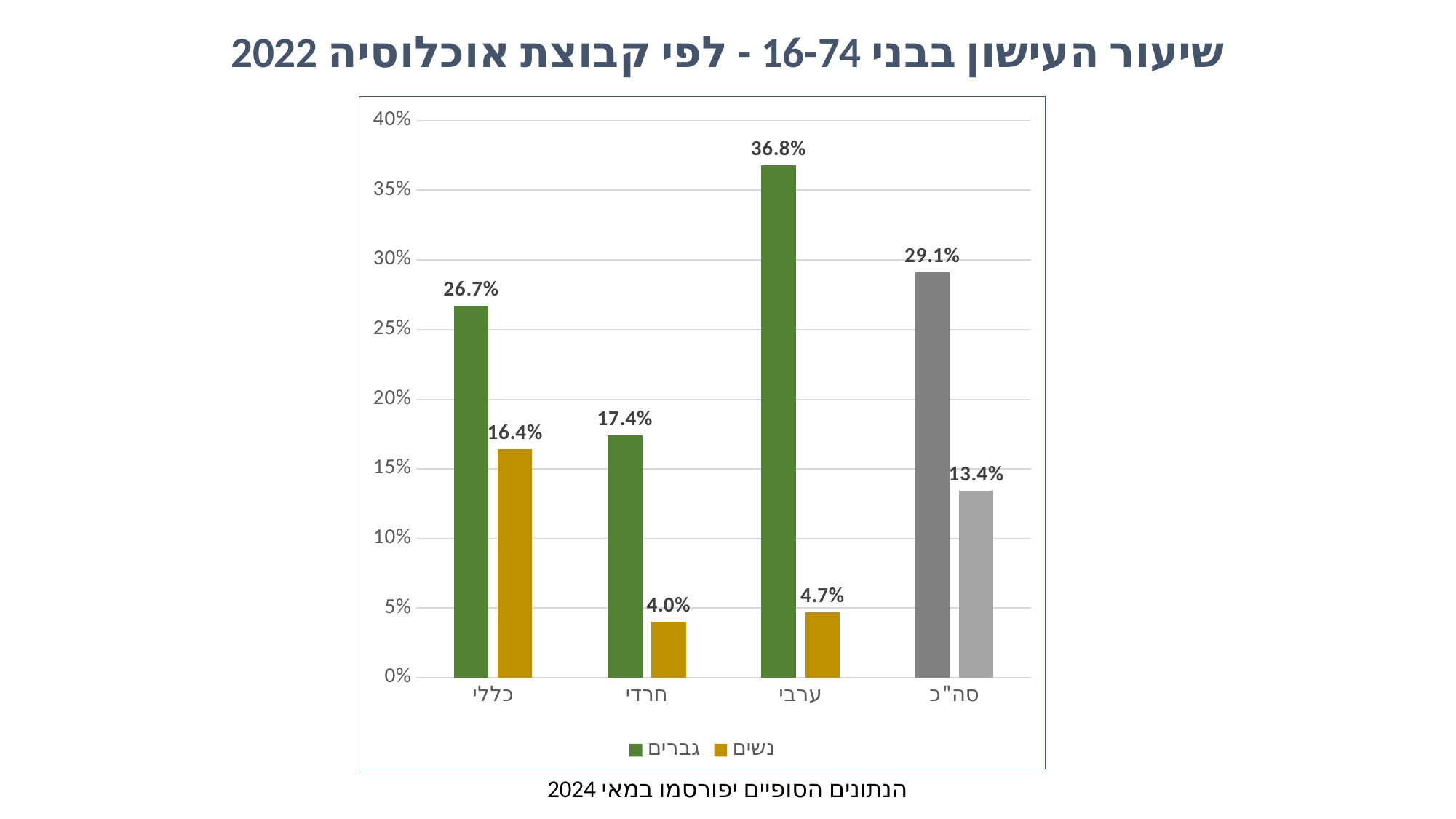
Which category has the highest value for גברים? ערבי What is the value for נשים in the סה"כ category? 13.4% How many series does the legend list? 2 Which is larger: the נשים value for כללי or the נשים value for סה"כ? כללי What is the value for גברים in the כללי category? 26.7% Is the value for גברים in the סה"כ category greater or less than 25%? greater What is the value for נשים in the חרדי category? 4.0% How many categories are shown on the x axis? 4 What is the difference between the גברים and נשים values in the ערבי category? 32.1% What kind of chart is shown on the slide? bar chart What is the value for גברים in the ערבי category? 36.8% Which category has the lowest value for נשים? חרדי